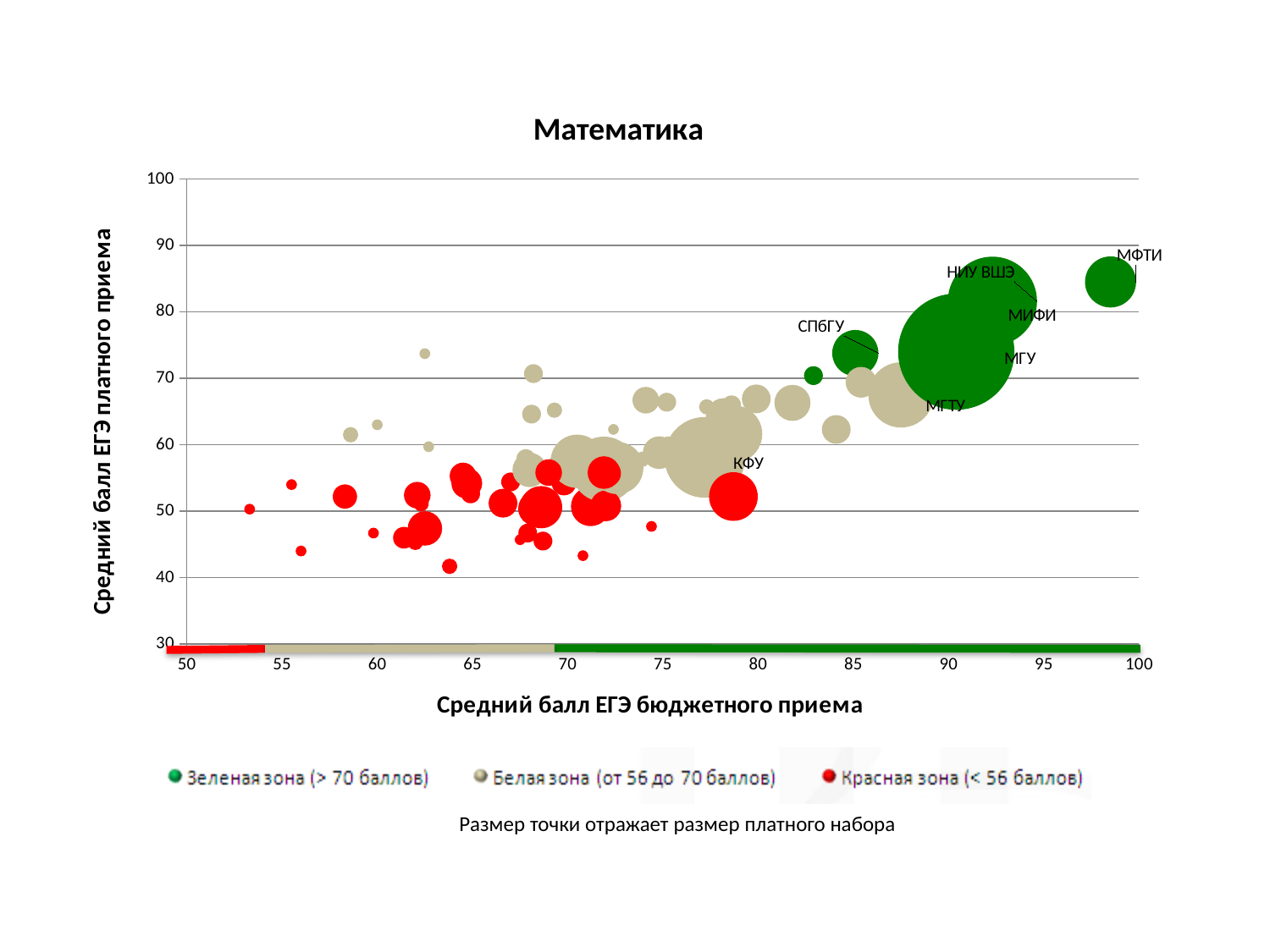
Which has the higher Средний балл ЕГЭ бюджетного приема, МФТИ or КФУ? МФТИ Is the value of Средний балл ЕГЭ платного приема for МГТУ greater or less than 70? less Is the value of Средний балл ЕГЭ платного приема for КФУ greater or less than 60? less Is the value of Средний балл ЕГЭ бюджетного приема for МФТИ greater or less than 95? greater What is the title of the chart? Математика Which legend entry corresponds to the red bubbles? Красная зона (< 56 баллов) What kind of chart is shown on the slide? Bubble chart Among the labeled universities, which has the lowest Средний балл ЕГЭ платного приема? КФУ Which has the higher Средний балл ЕГЭ платного приема, МФТИ or МГТУ? МФТИ How many series does the legend list? 3